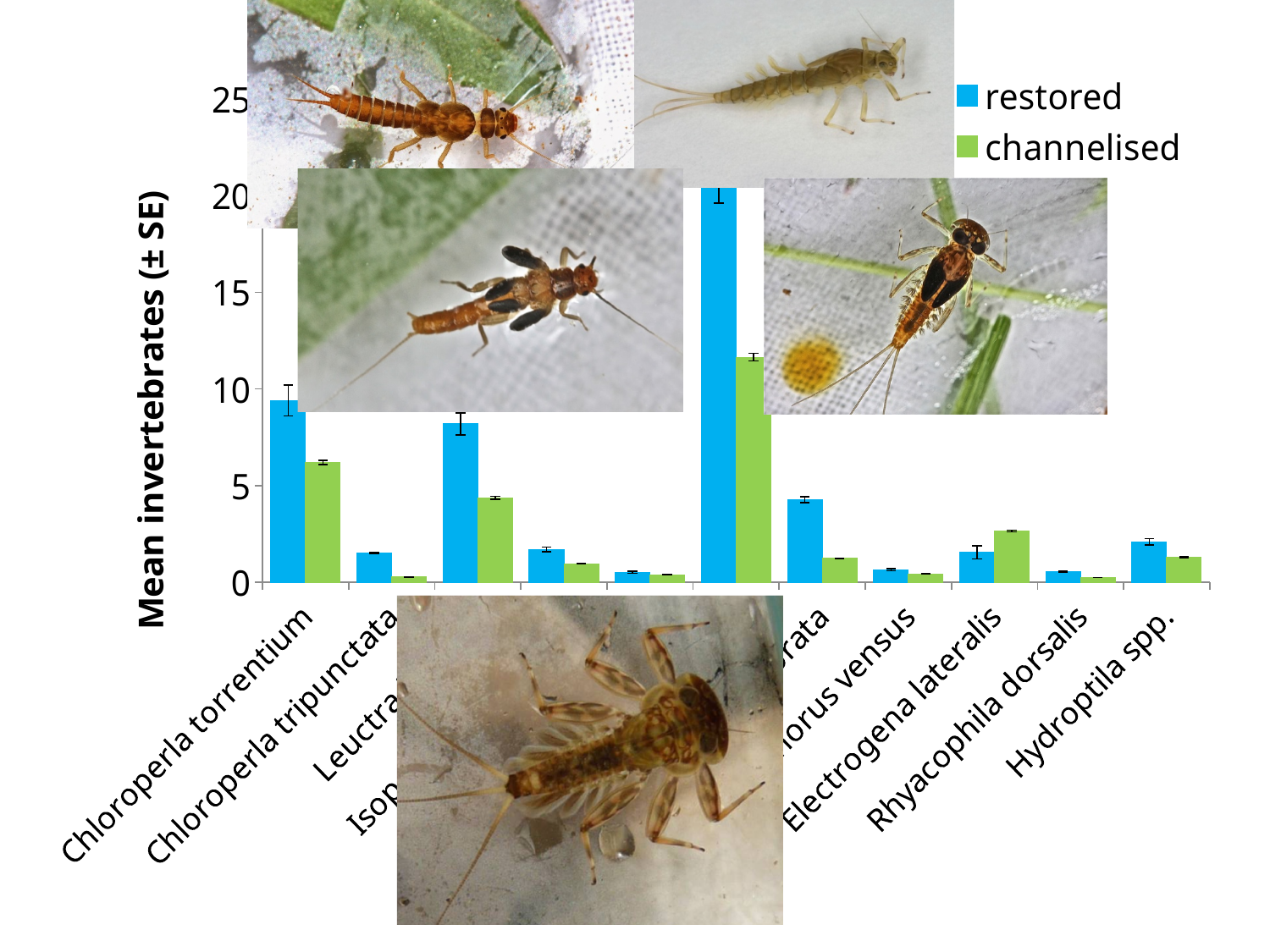
Is the channelised value for Chloroperla torrentium greater or less than 5? greater Is the restored value for Chloroperla tripunctata greater or less than 5? less Is the restored value for Chloroperla torrentium greater or less than 5? greater For Electrogena lateralis, which is larger: the restored or the channelised value? channelised How many categories (taxa) are plotted along the x axis? 11 What are the two series named in the legend? restored and channelised For Hydroptila spp., which is larger: the restored or the channelised value? restored How many series does the legend list? 2 For Chloroperla torrentium, which is larger: the restored or the channelised value? restored What is the title of the vertical axis? Mean invertebrates (± SE) What kind of chart is shown on the slide? bar chart